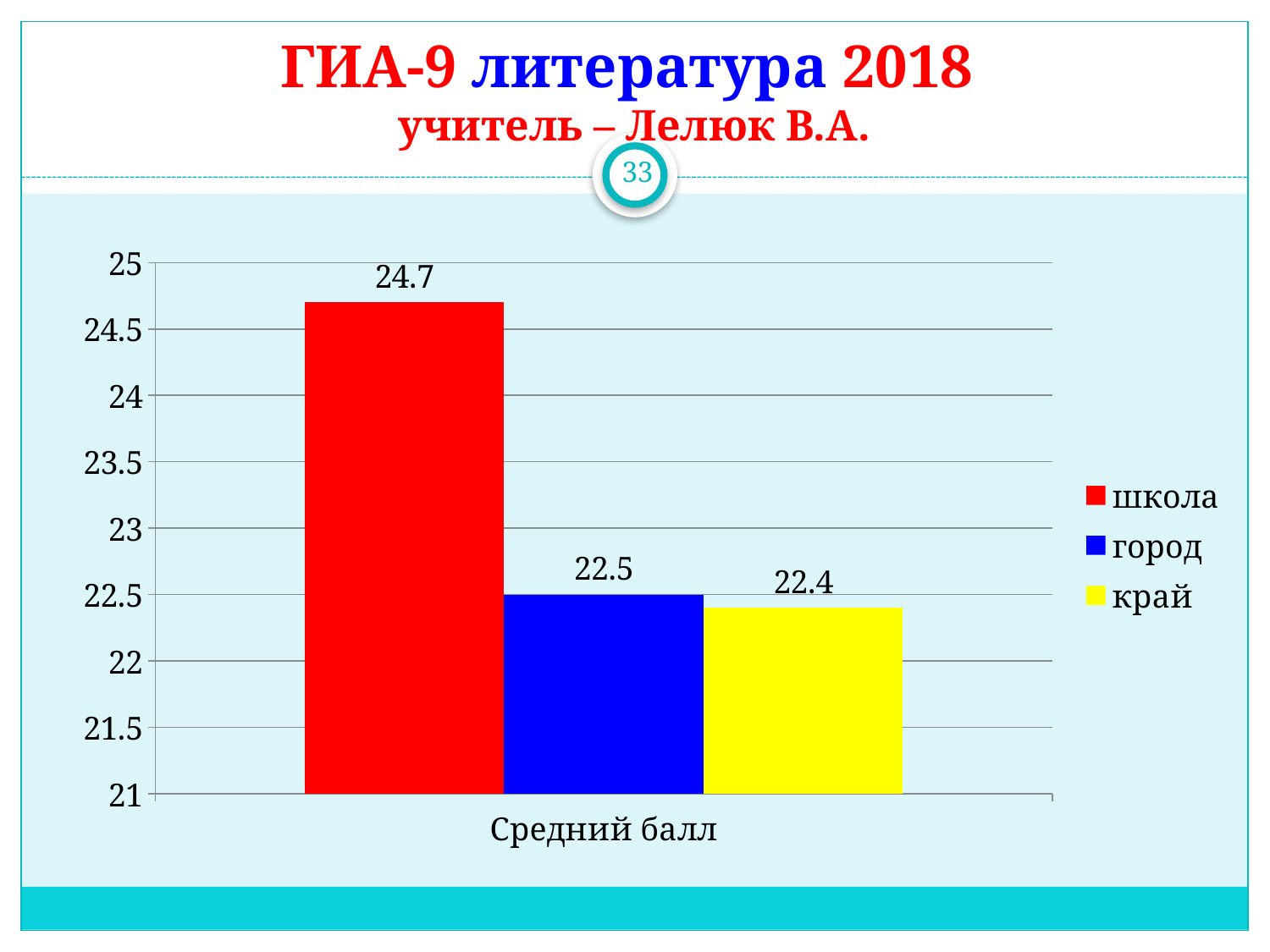
What is the difference between the город value and the край value? 0.1 What is the value for школа (school) in the Средний балл chart? 24.7 Which series has the highest average score? школа What is the value for край (region) in the Средний балл chart? 22.4 How many series does the legend list? 3 Is the value for школа greater or less than 24? greater What colour is the bar for город? blue What is the difference between the школа value and the город value? 2.2 Which is larger, the value for школа or the value for край? школа Which series has the lowest average score? край What kind of chart is shown on the slide? bar chart What is the value for город (city) in the Средний балл chart? 22.5